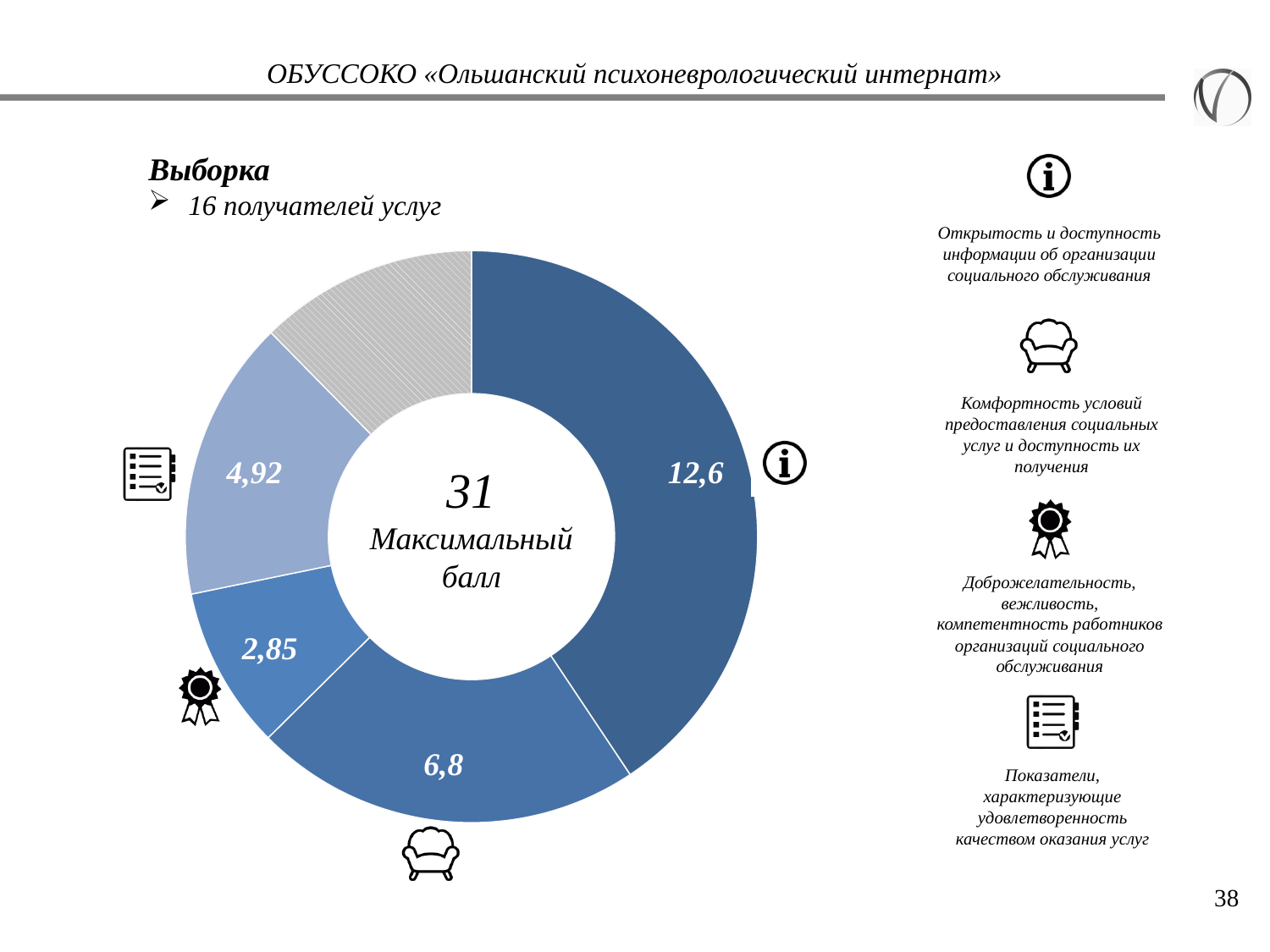
Which labelled slice has the highest value? 12,6 (Открытость и доступность информации) What value is shown for the slice marked with the checklist icon (Показатели, характеризующие удовлетворенность качеством оказания услуг)? 4,92 Which is larger: the checklist-icon slice or the medal-icon slice? The checklist-icon slice (4,92) What value is shown for the slice marked with the information icon (Открытость и доступность информации об организации социального обслуживания)? 12,6 What is the difference between the information-icon slice (12,6) and the armchair-icon slice (6,8)? 5,8 How many service recipients (получателей услуг) are in the sample according to the slide? 16 What type of chart is shown on the slide? Donut (pie) chart What number is shown in the centre of the donut chart as the maximum score (Максимальный балл)? 31 Which labelled slice has the lowest value? 2,85 (Доброжелательность, вежливость, компетентность работников) What value is shown for the slice marked with the medal icon (Доброжелательность, вежливость, компетентность работников)? 2,85 What value is shown for the slice marked with the armchair icon (Комфортность условий предоставления социальных услуг и доступность их получения)? 6,8 How many slices with printed value labels does the donut chart have? 4